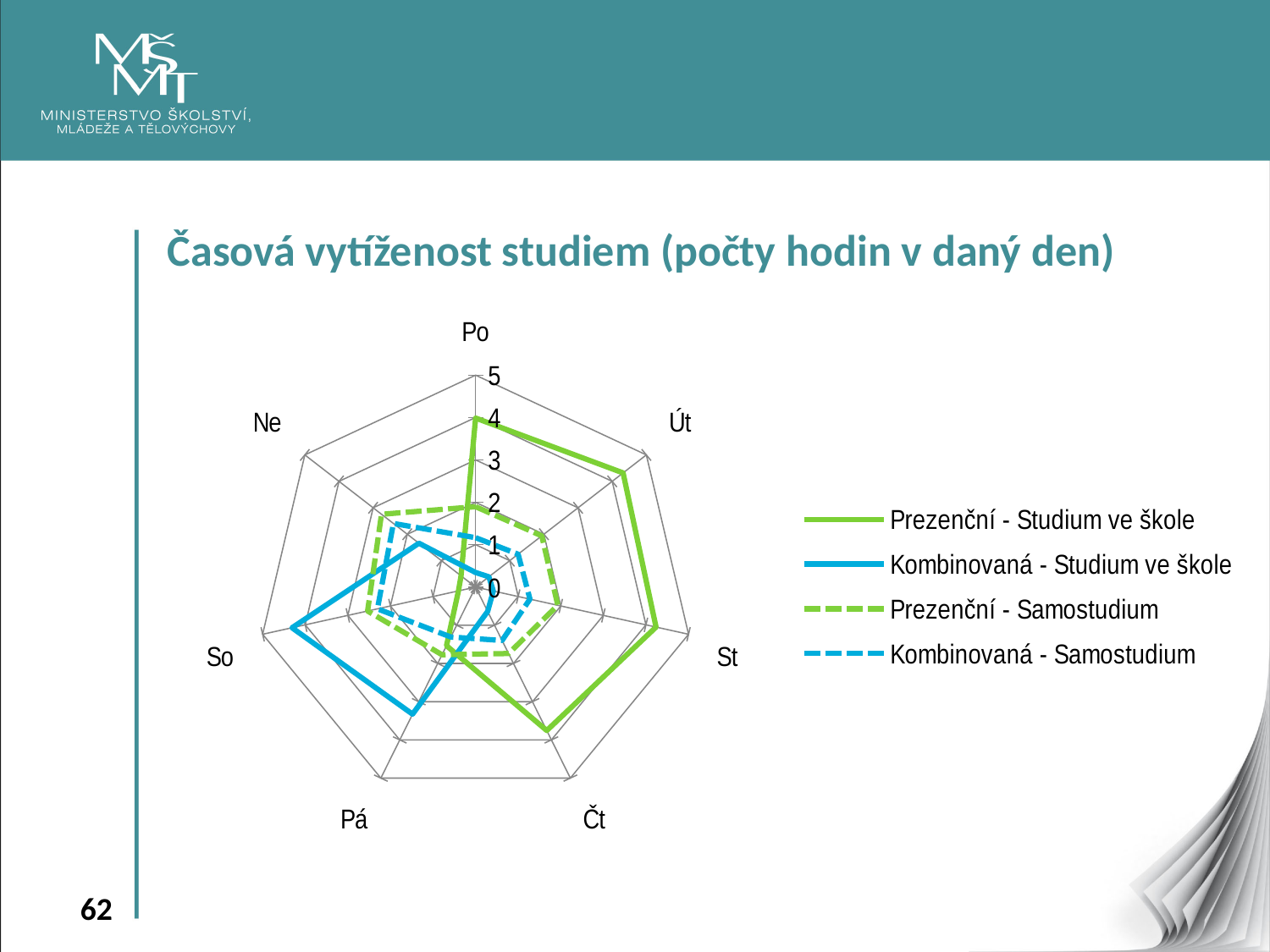
On which day does the series Kombinovaná - Studium ve škole reach its highest value? So For Út, which series has the larger value: Prezenční - Studium ve škole or Kombinovaná - Studium ve škole? Prezenční - Studium ve škole For So, which series has the larger value: Prezenční - Studium ve škole or Kombinovaná - Studium ve škole? Kombinovaná - Studium ve škole Is the value for So in the series Kombinovaná - Studium ve škole greater or less than 3? greater Is the value for Po in the series Kombinovaná - Studium ve škole greater or less than 1? less How many categories (days) does the chart have? 7 What kind of chart is shown on the slide? radar chart Is the value for So in the series Prezenční - Studium ve škole greater or less than 1? less What is the title of the chart? Časová vytíženost studiem (počty hodin v daný den) Which legend entry is drawn as a solid blue line? Kombinovaná - Studium ve škole How many series does the legend list? 4